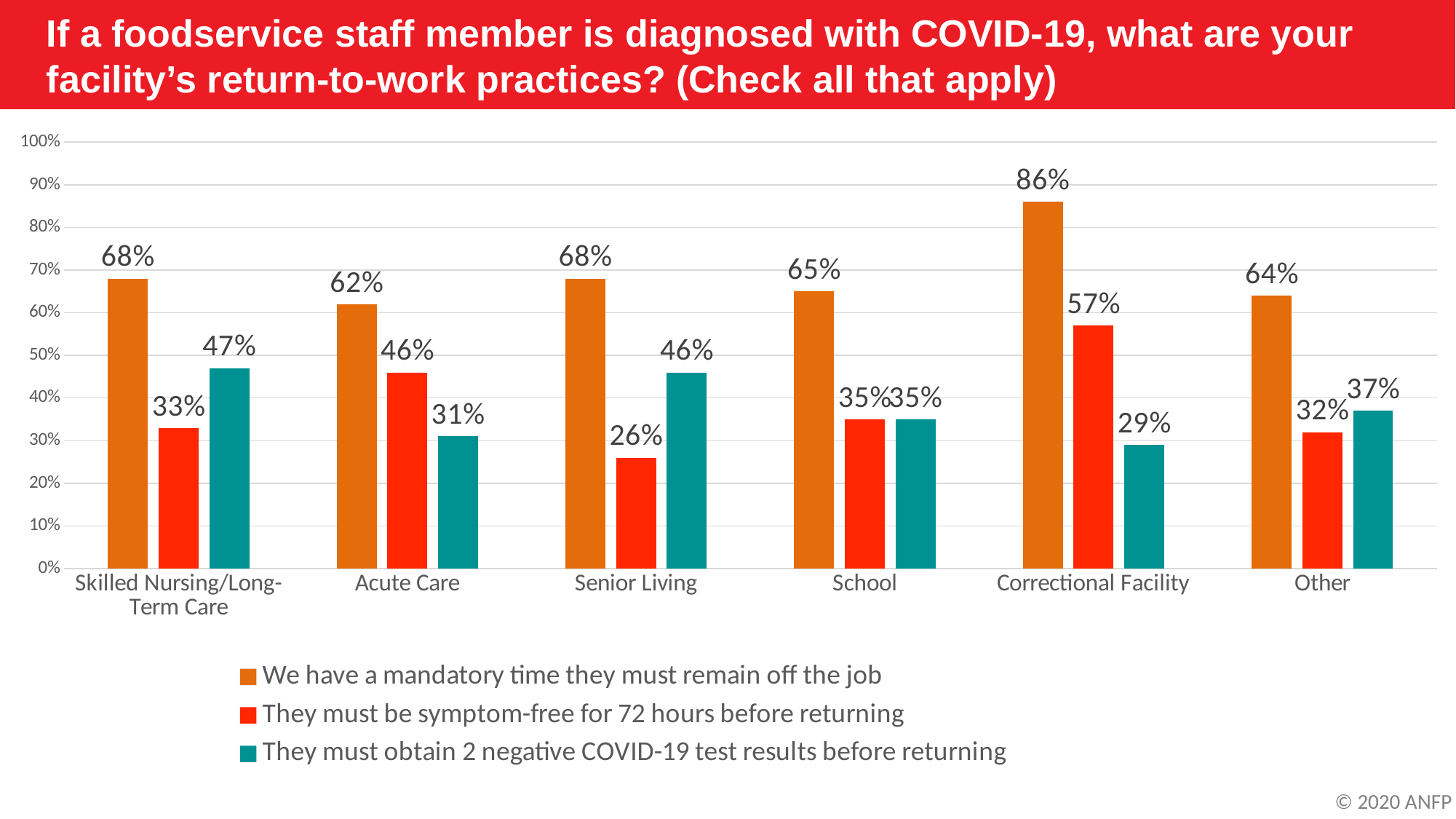
What kind of chart is shown on the slide? Bar chart What is the value for 'They must obtain 2 negative COVID-19 test results before returning' for the Other category? 37% How many facility types are shown on the x axis? 6 What percentage of Skilled Nursing/Long-Term Care respondents said staff must obtain 2 negative COVID-19 test results before returning? 47% Which colour represents 'They must be symptom-free for 72 hours before returning' in the legend? Red What percentage of Senior Living respondents said staff must be symptom-free for 72 hours before returning? 26% For Acute Care, which is larger: the value for 'They must be symptom-free for 72 hours before returning' or the value for 'They must obtain 2 negative COVID-19 test results before returning'? They must be symptom-free for 72 hours before returning Which facility type has the highest value for 'We have a mandatory time they must remain off the job'? Correctional Facility What percentage of Correctional Facility respondents said they have a mandatory time staff must remain off the job? 86% Which facility type has the lowest value for 'They must be symptom-free for 72 hours before returning'? Senior Living What is the difference between the Correctional Facility and Acute Care values for 'We have a mandatory time they must remain off the job'? 24 percentage points How many series does the legend list? 3